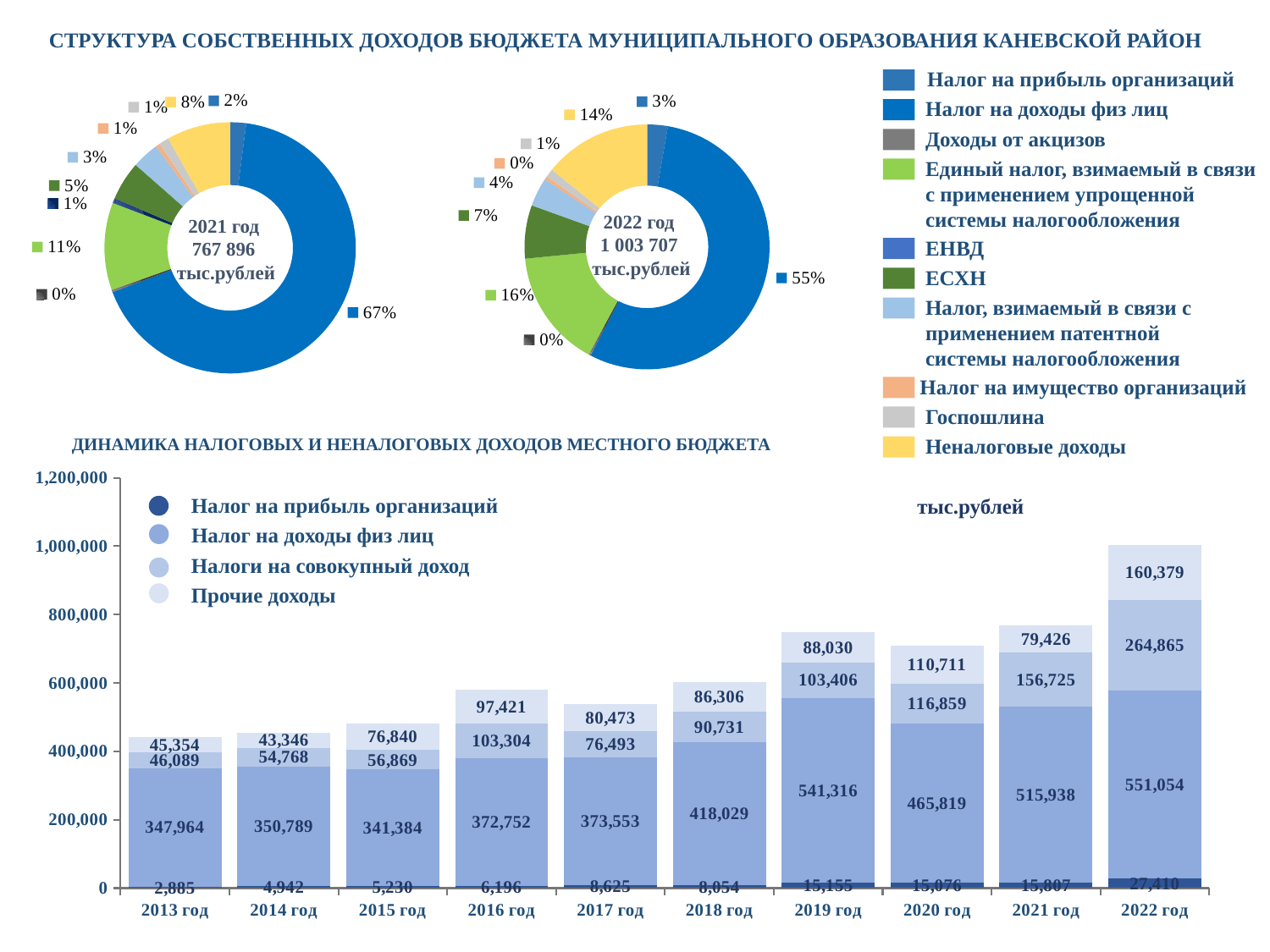
How many years are shown on the x axis of the bar chart ДИНАМИКА НАЛОГОВЫХ И НЕНАЛОГОВЫХ ДОХОДОВ МЕСТНОГО БЮДЖЕТА? 10 In the 2022 donut chart, which category has the largest share? Налог на доходы физ лиц What total value is shown in the centre of the 2021 donut chart? 767 896 тыс.рублей In the bar chart ДИНАМИКА НАЛОГОВЫХ И НЕНАЛОГОВЫХ ДОХОДОВ МЕСТНОГО БЮДЖЕТА, what is the total of the stacked bar for 2019 год? 747,907 In the 2021 donut chart, what share of own budget revenues comes from Налог на доходы физ лиц? 67% In the bar chart ДИНАМИКА НАЛОГОВЫХ И НЕНАЛОГОВЫХ ДОХОДОВ МЕСТНОГО БЮДЖЕТА, in which year is Налог на доходы физ лиц the lowest? 2015 год In the bar chart ДИНАМИКА НАЛОГОВЫХ И НЕНАЛОГОВЫХ ДОХОДОВ МЕСТНОГО БЮДЖЕТА, what is the value of Налог на доходы физ лиц for 2018 год? 418,029 In the 2022 donut chart, what share is Неналоговые доходы? 14% In the bar chart ДИНАМИКА НАЛОГОВЫХ И НЕНАЛОГОВЫХ ДОХОДОВ МЕСТНОГО БЮДЖЕТА, which year has the larger value for Прочие доходы, 2016 год or 2017 год? 2016 год In the bar chart ДИНАМИКА НАЛОГОВЫХ И НЕНАЛОГОВЫХ ДОХОДОВ МЕСТНОГО БЮДЖЕТА, by how much did Налог на доходы физ лиц increase from 2021 год to 2022 год? 35,116 How many series does the legend of the bar chart ДИНАМИКА НАЛОГОВЫХ И НЕНАЛОГОВЫХ ДОХОДОВ МЕСТНОГО БЮДЖЕТА list? 4 What type of chart is the chart titled ДИНАМИКА НАЛОГОВЫХ И НЕНАЛОГОВЫХ ДОХОДОВ МЕСТНОГО БЮДЖЕТА? Stacked bar chart